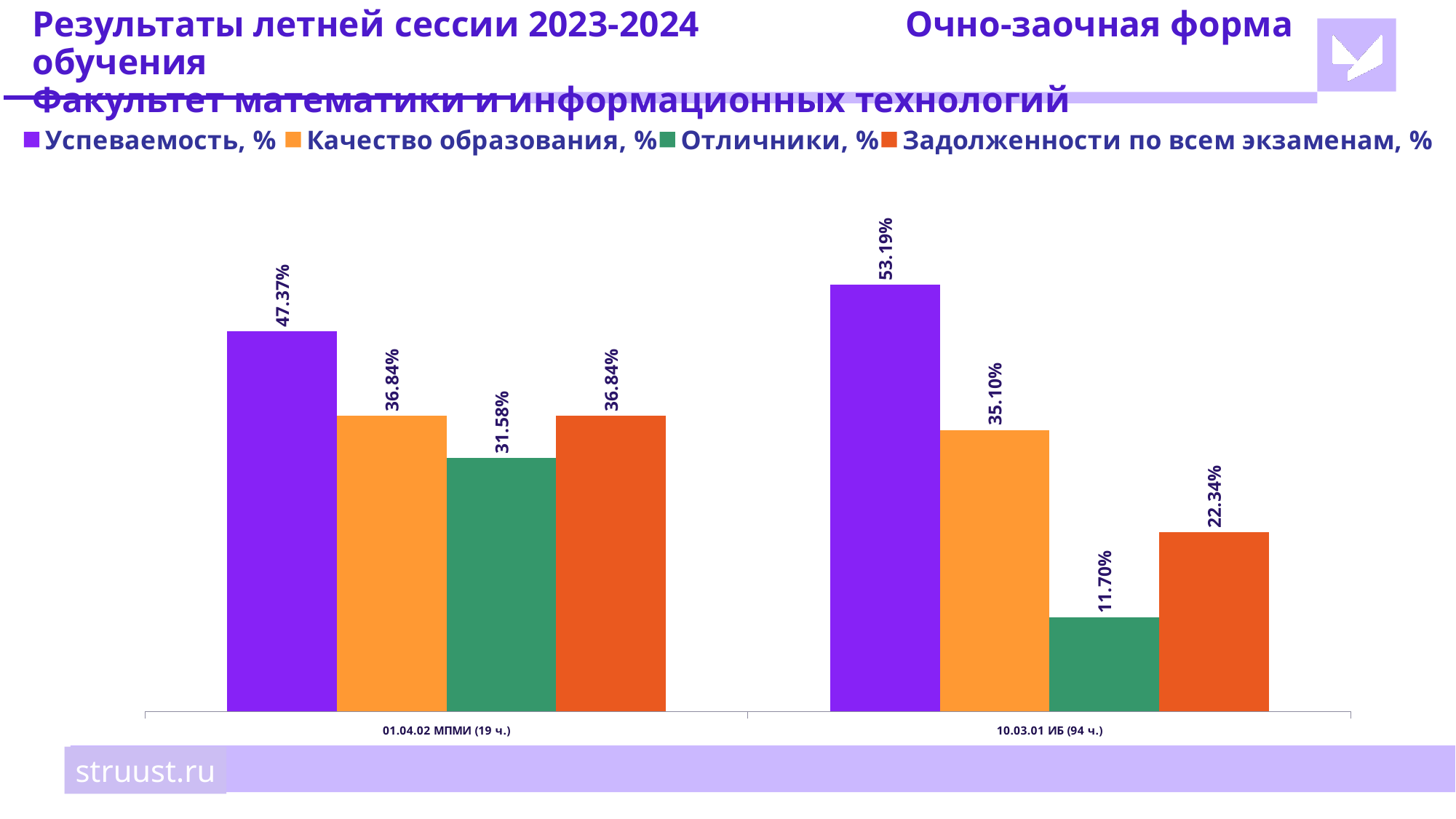
How many series does the legend list? 4 Is Отличники, % larger for 01.04.02 МПМИ (19 ч.) or for 10.03.01 ИБ (94 ч.)? 01.04.02 МПМИ (19 ч.) What is the value of Отличники, % for 10.03.01 ИБ (94 ч.)? 11.70% What is the difference between Успеваемость, % for 10.03.01 ИБ (94 ч.) and for 01.04.02 МПМИ (19 ч.)? 5.82% What is the value of Успеваемость, % for 01.04.02 МПМИ (19 ч.)? 47.37% What kind of chart is shown on the slide? bar chart Which colour represents Задолженности по всем экзаменам, % in the legend? orange-red How many categories are shown on the x axis? 2 Which series has the lowest value for 10.03.01 ИБ (94 ч.)? Отличники, % What is the value of Качество образования, % for 01.04.02 МПМИ (19 ч.)? 36.84% What is the value of Задолженности по всем экзаменам, % for 10.03.01 ИБ (94 ч.)? 22.34% Which category has the higher value for Успеваемость, %? 10.03.01 ИБ (94 ч.)